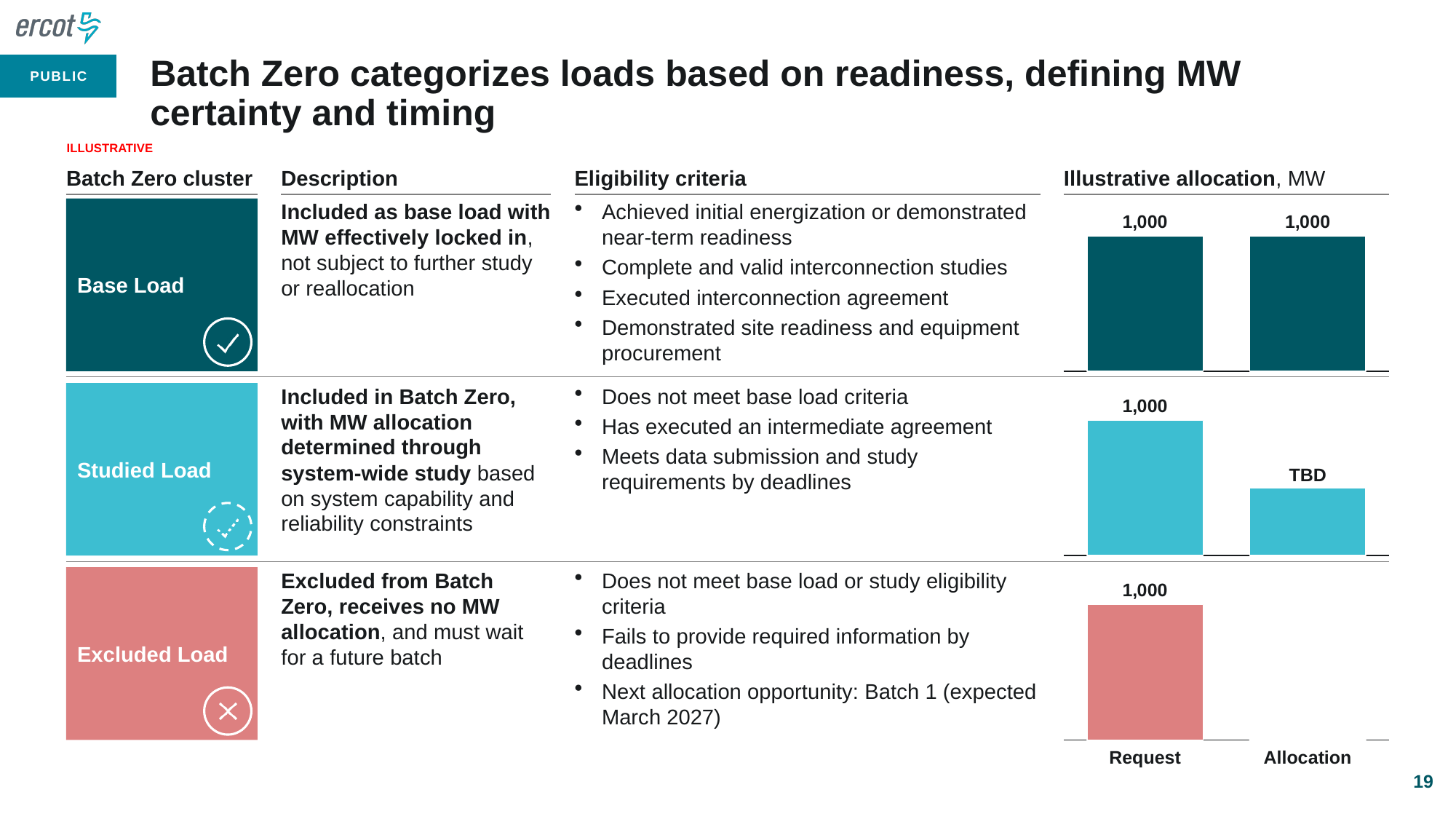
How many bars are shown in the Base Load row of the Illustrative allocation chart? 2 What are the two category labels at the bottom of the Illustrative allocation charts? Request and Allocation In the Excluded Load row of the Illustrative allocation chart, is there an Allocation bar shown? No In the Studied Load row of the Illustrative allocation chart, what label is shown above the Allocation bar? TBD In the Studied Load row of the Illustrative allocation chart, what is the Request value? 1,000 What kind of chart is used in the Illustrative allocation column? Bar chart In the Excluded Load row of the Illustrative allocation chart, what is the Request value? 1,000 What unit is stated in the header of the Illustrative allocation column? MW In the Base Load row of the Illustrative allocation chart, what is the Allocation value? 1,000 In the Base Load row of the Illustrative allocation chart, what is the difference between the Request and Allocation values? 0 In the Studied Load row of the Illustrative allocation chart, which bar is taller, Request or Allocation? Request In the Base Load row of the Illustrative allocation chart, what is the Request value? 1,000